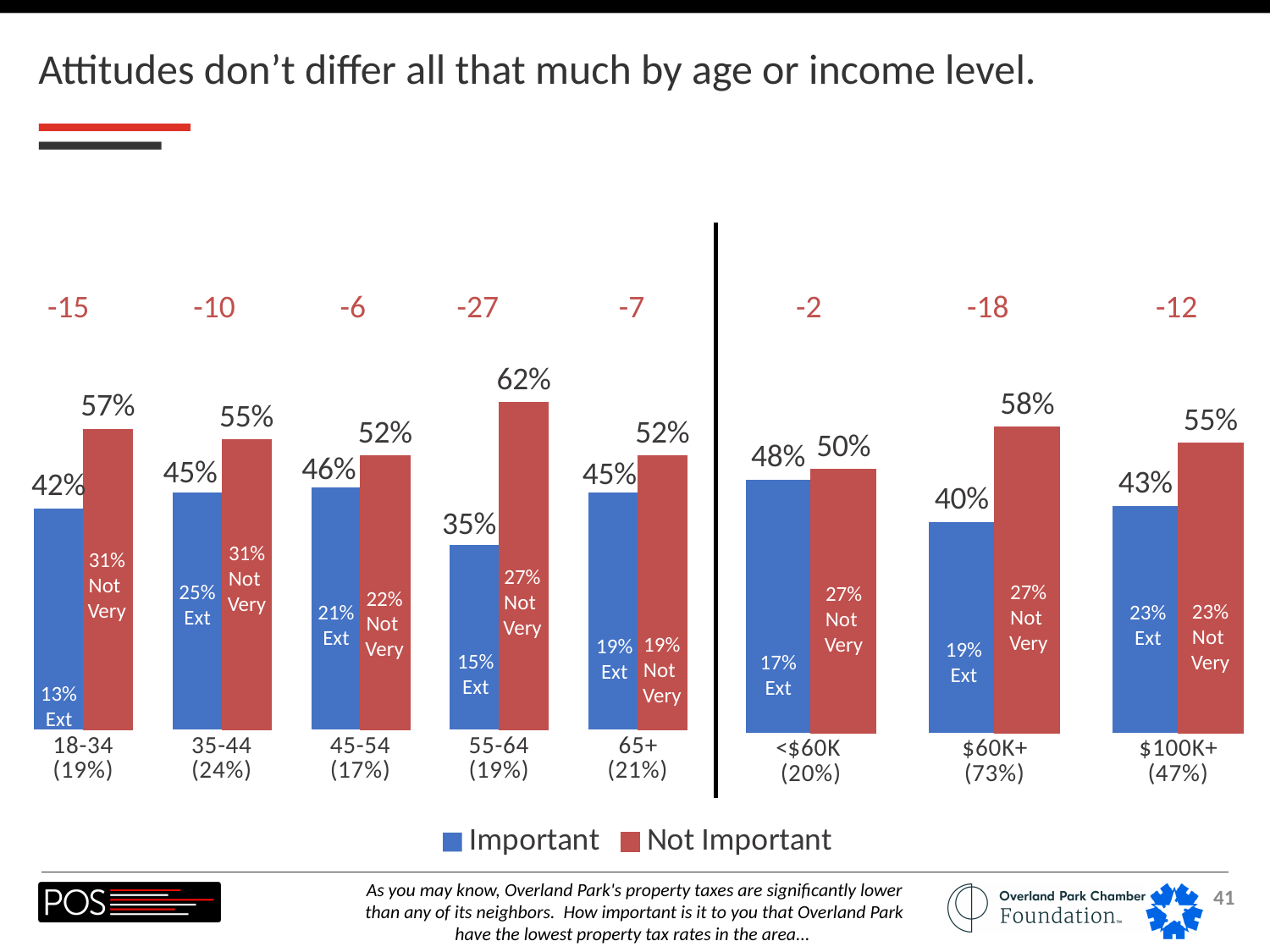
How many series does the legend list? 2 What is the difference between the Not Important and Important values for the $60K+ group? 18 Which is larger for the 45-54 age group, the Important value or the Not Important value? Not Important What percentage of the 55-64 age group says it is Not Important? 62% What is the Not Important value for the $100K+ income group? 55% Which category has the lowest Important value? 55-64 What kind of chart is shown on the slide? Bar chart What is the 'Ext' (extremely important) share for the 18-34 age group? 13% What are the two series named in the legend? Important and Not Important How many categories are shown on the x axis of the chart? 8 What is the Important value for the <$60K income group? 48% Which category has the highest Not Important value? 55-64